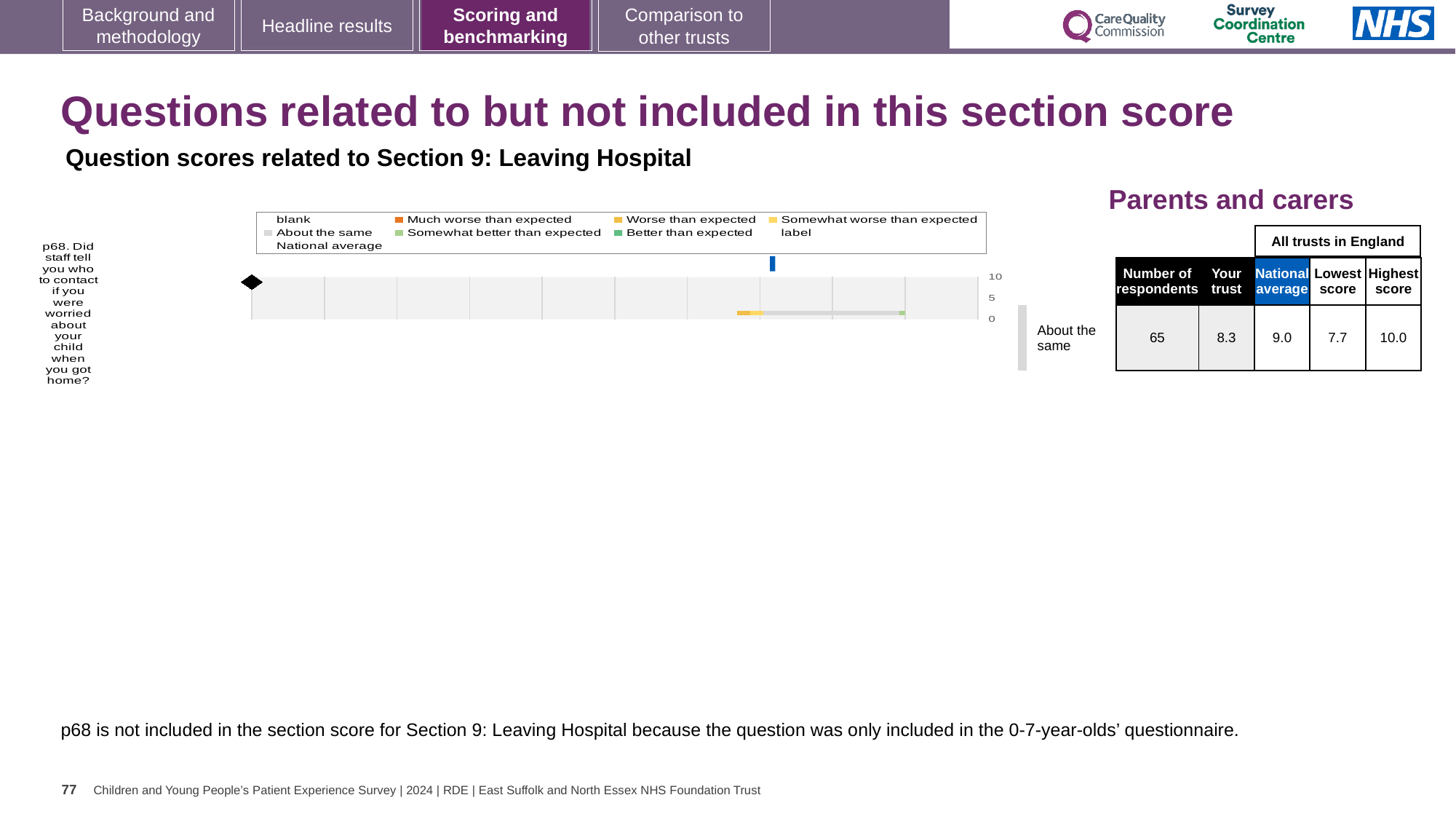
Which question number is plotted in the chart? p68 What kind of chart is used to show the p68 question score? bar chart What is the highest score among all trusts in England for p68? 10.0 What is the 'Your trust' score for p68? 8.3 Which is larger for p68, the trust's score or the national average? National average How many questions are plotted in the chart? 1 What is the lowest score among all trusts in England for p68? 7.7 What is the national average score for p68? 9.0 What benchmark category is the trust's p68 score placed in? About the same How many respondents answered p68? 65 What is the difference between the national average and the trust's score for p68? 0.7 How many entries does the chart legend list? 9